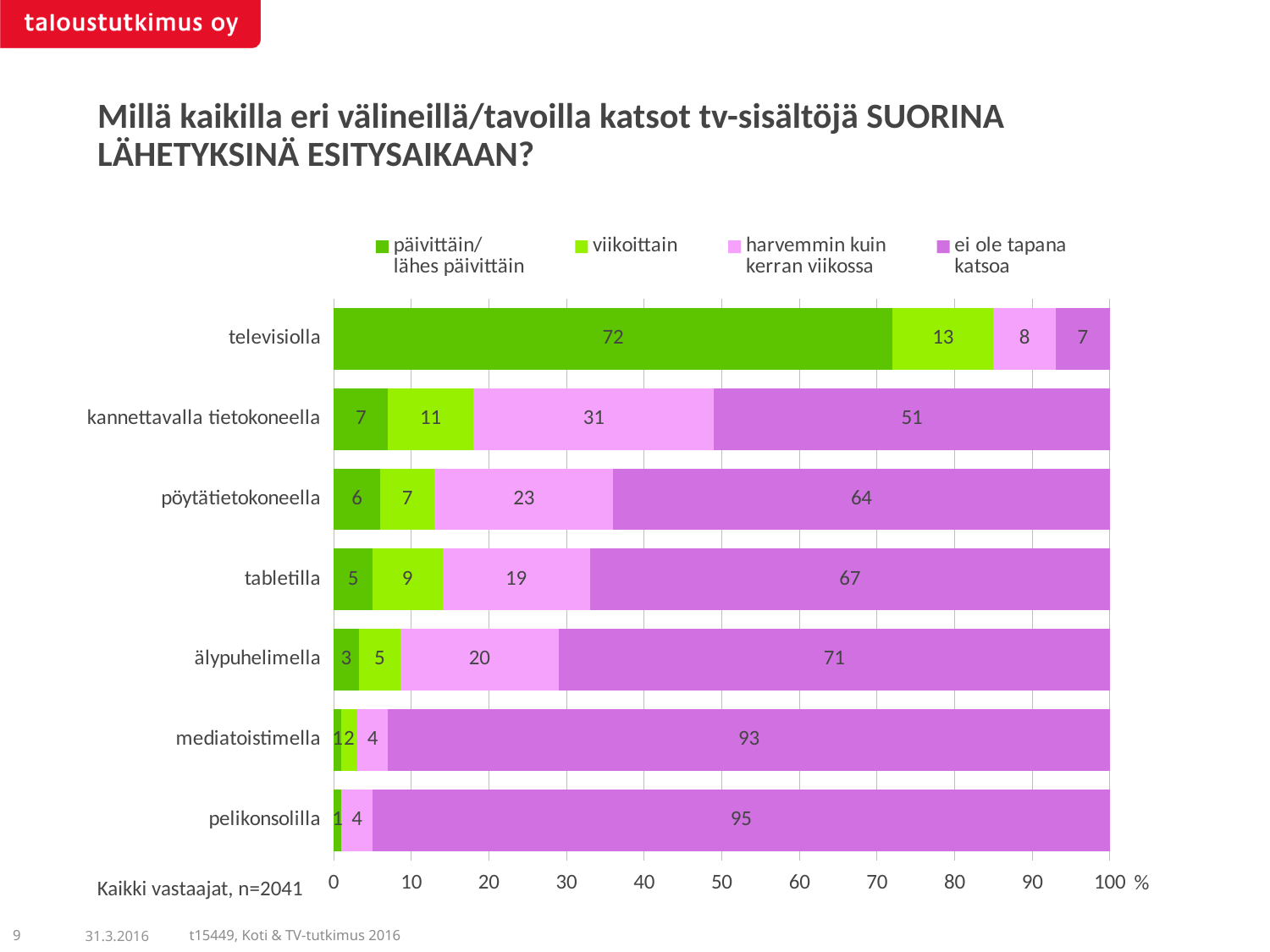
Which has the larger 'päivittäin/lähes päivittäin' value, kannettavalla tietokoneella or pöytätietokoneella? kannettavalla tietokoneella What is the difference between the 'harvemmin kuin kerran viikossa' values for kannettavalla tietokoneella and pöytätietokoneella? 8 What kind of chart is shown on the slide? stacked bar chart What is the total of the stacked bar for televisiolla? 100 What is the value for 'ei ole tapana katsoa' for tabletilla? 67 Which category has the lowest value for 'ei ole tapana katsoa'? televisiolla What is the first entry in the chart legend? päivittäin/lähes päivittäin What is the value for 'viikoittain' for älypuhelimella? 5 How many series does the legend list? 4 How many categories are shown on the chart? 7 Which category has the highest value for 'ei ole tapana katsoa'? pelikonsolilla What is the value for 'päivittäin/lähes päivittäin' for televisiolla? 72